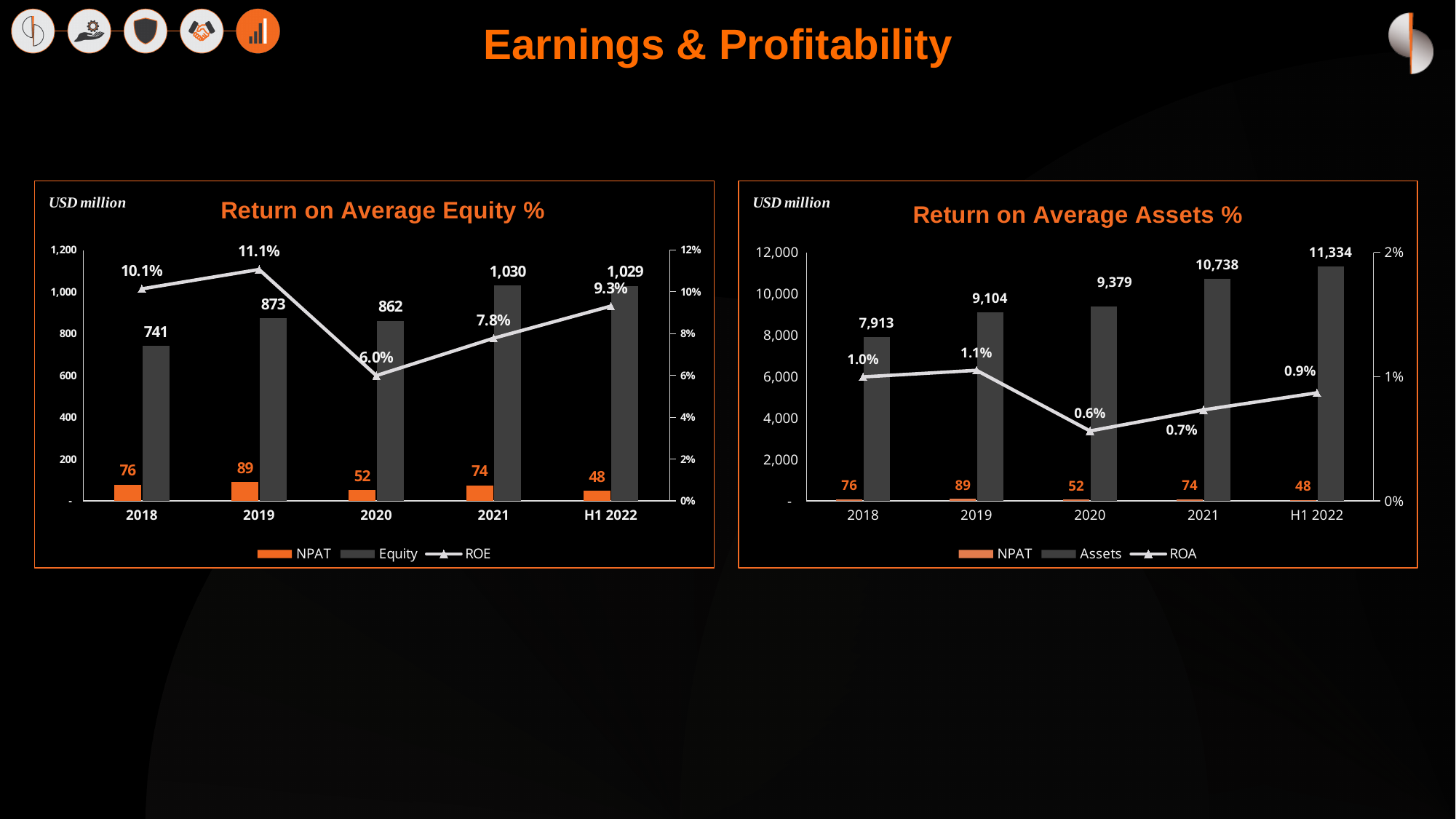
In the Return on Average Equity % chart, which year has the highest ROE? 2019 In the Return on Average Equity % chart, what is the difference between the Equity values for 2019 and 2018? 132 In the Return on Average Equity % chart, what is the ROE for 2020? 6.0% In the Return on Average Equity % chart, which year has the lowest NPAT? H1 2022 In the Return on Average Assets % chart, what is the Assets value for H1 2022? 11,334 In the Return on Average Assets % chart, what is the ROA for 2021? 0.7% In the Return on Average Assets % chart, do the Assets values rise or fall from 2018 to H1 2022? Rise In the Return on Average Equity % chart, how many series does the legend list? 3 In the Return on Average Assets % chart, is the Assets value for 2020 larger than the Assets value for 2019? Yes In the Return on Average Equity % chart, what is the Equity value for 2021? 1,030 In the Return on Average Assets % chart, which year has the lowest ROA? 2020 In the Return on Average Assets % chart, how many periods are shown on the x axis? 5